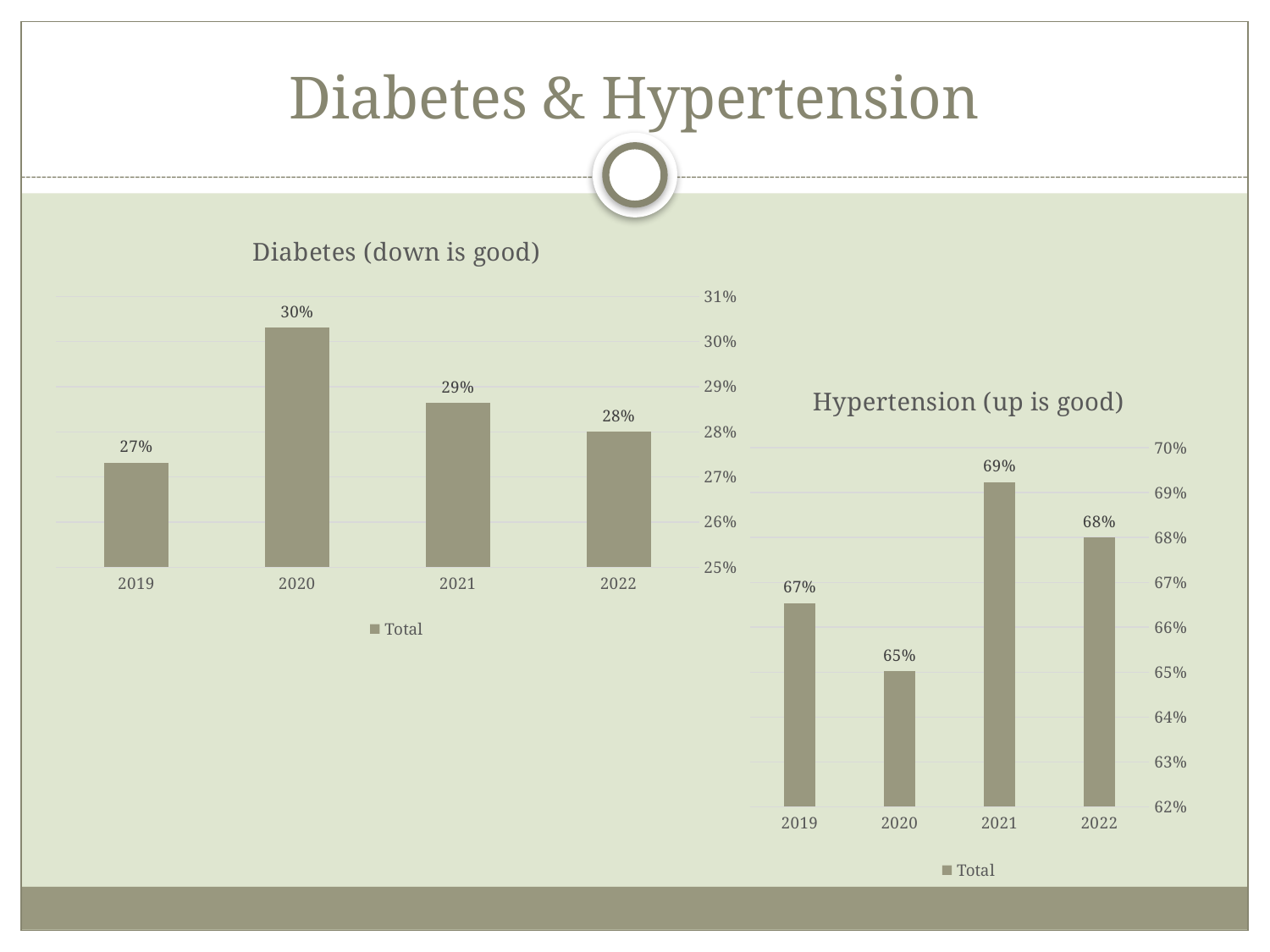
In the 'Diabetes (down is good)' chart, what is the value for 2020? 30% In the 'Hypertension (up is good)' chart, what is the difference between the values for 2021 and 2020? 4% In the 'Hypertension (up is good)' chart, what is the value for 2021? 69% How many years are shown in the 'Hypertension (up is good)' chart? 4 How many series does the legend of the 'Diabetes (down is good)' chart list? 1 In the 'Hypertension (up is good)' chart, which is larger, the value for 2019 or the value for 2022? 2022 In the 'Hypertension (up is good)' chart, which year has the lowest value? 2020 What kind of chart is the 'Hypertension (up is good)' chart? Bar chart In the 'Diabetes (down is good)' chart, do the values rise or fall from 2020 to 2022? Fall In the 'Diabetes (down is good)' chart, what is the difference between the values for 2020 and 2019? 3% In the 'Diabetes (down is good)' chart, which year has the highest value? 2020 In the 'Diabetes (down is good)' chart, is the value for 2021 greater or less than 28%? greater